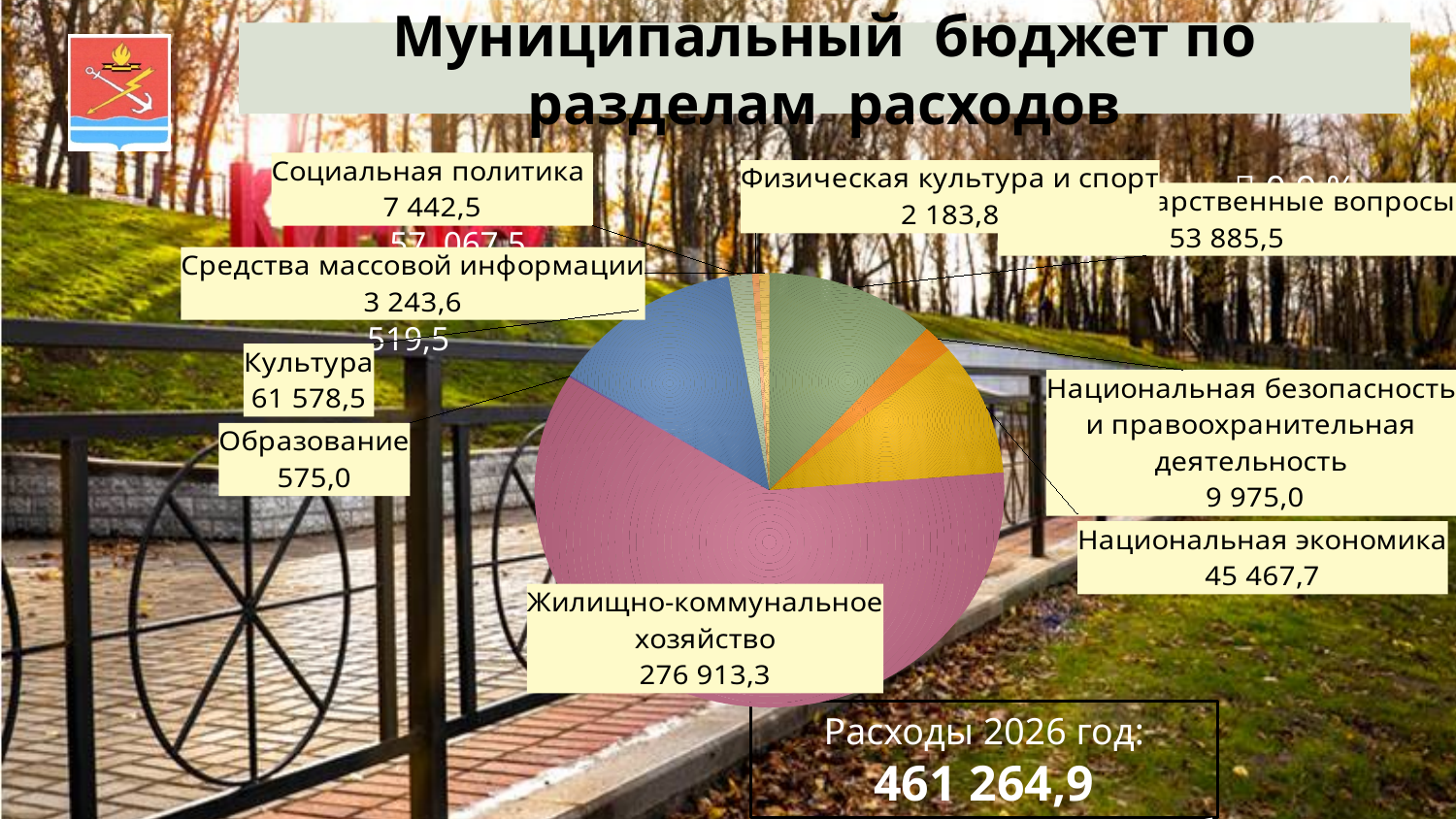
What is the value for Жилищно-коммунальное хозяйство? 276 913,3 Which category has the largest value? Жилищно-коммунальное хозяйство What is the title of the slide's chart? Муниципальный бюджет по разделам расходов Which is larger, Культура or Национальная экономика? Культура What kind of chart is shown on the slide? pie chart What is the value for Физическая культура и спорт? 2 183,8 What is the value for Национальная безопасность и правоохранительная деятельность? 9 975,0 What is the value for Национальная экономика? 45 467,7 What total is given for Расходы 2026 год? 461 264,9 What is the difference between Культура and Национальная экономика? 16 110,8 What is the difference between Социальная политика and Средства массовой информации? 4 198,9 What is the value for Культура? 61 578,5